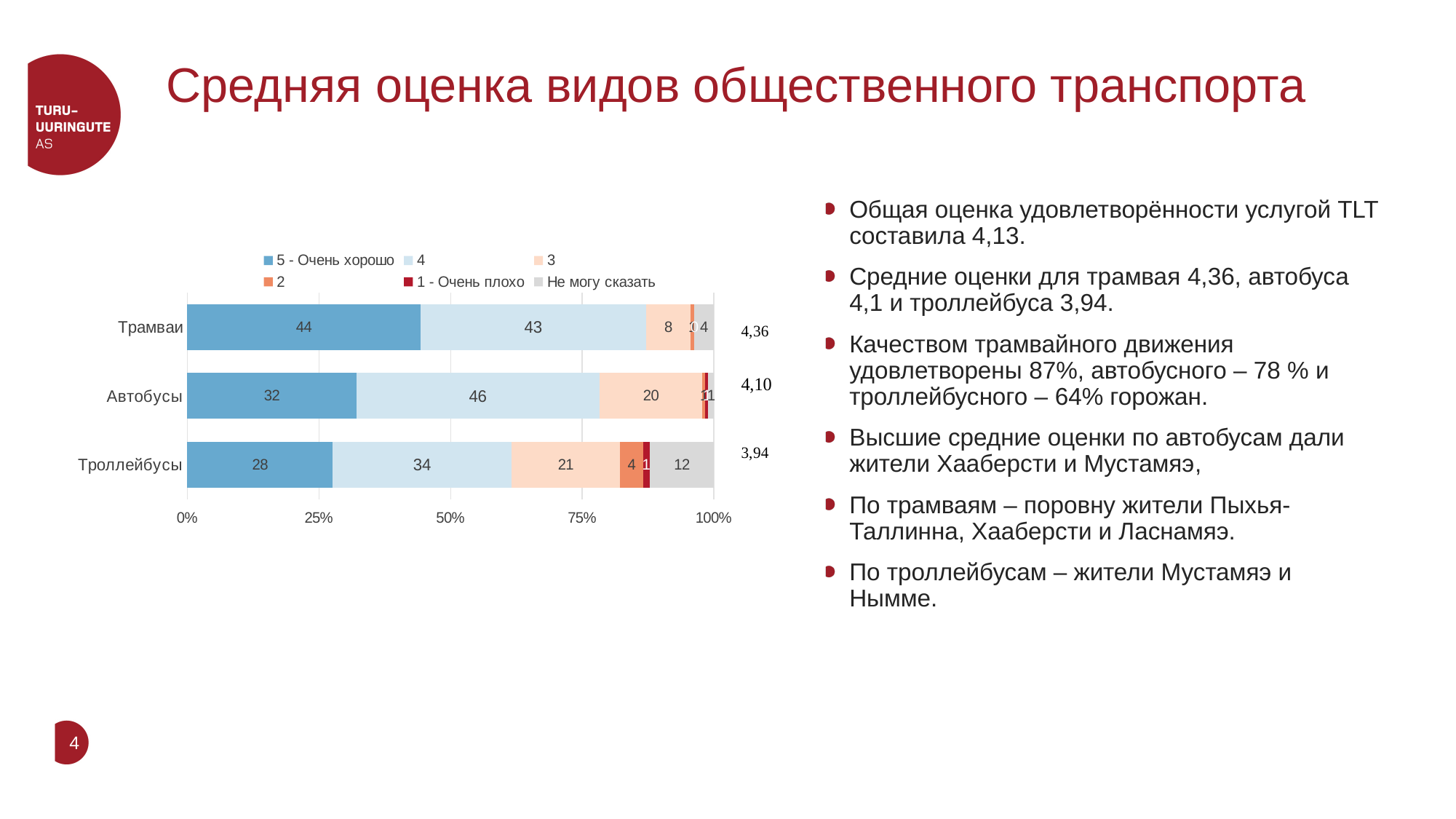
What is the difference between the '5 - Очень хорошо' values for Трамваи and Троллейбусы? 16 What is the value of the 'Не могу сказать' segment for Троллейбусы? 12 What is the value of the '3' segment for Троллейбусы? 21 What type of chart is shown on the slide? Stacked bar chart Which is larger: the '3' segment for Автобусы or the '3' segment for Трамваи? Автобусы Which transport category has the lowest '5 - Очень хорошо' value? Троллейбусы What average score is shown next to the bar for Троллейбусы? 3,94 What is the value of the '4' segment for Автобусы? 46 Which transport category has the highest '5 - Очень хорошо' value? Трамваи What is the value of the '5 - Очень хорошо' segment for Трамваи? 44 How many series does the chart legend list? 6 How many transport categories are shown on the chart? 3